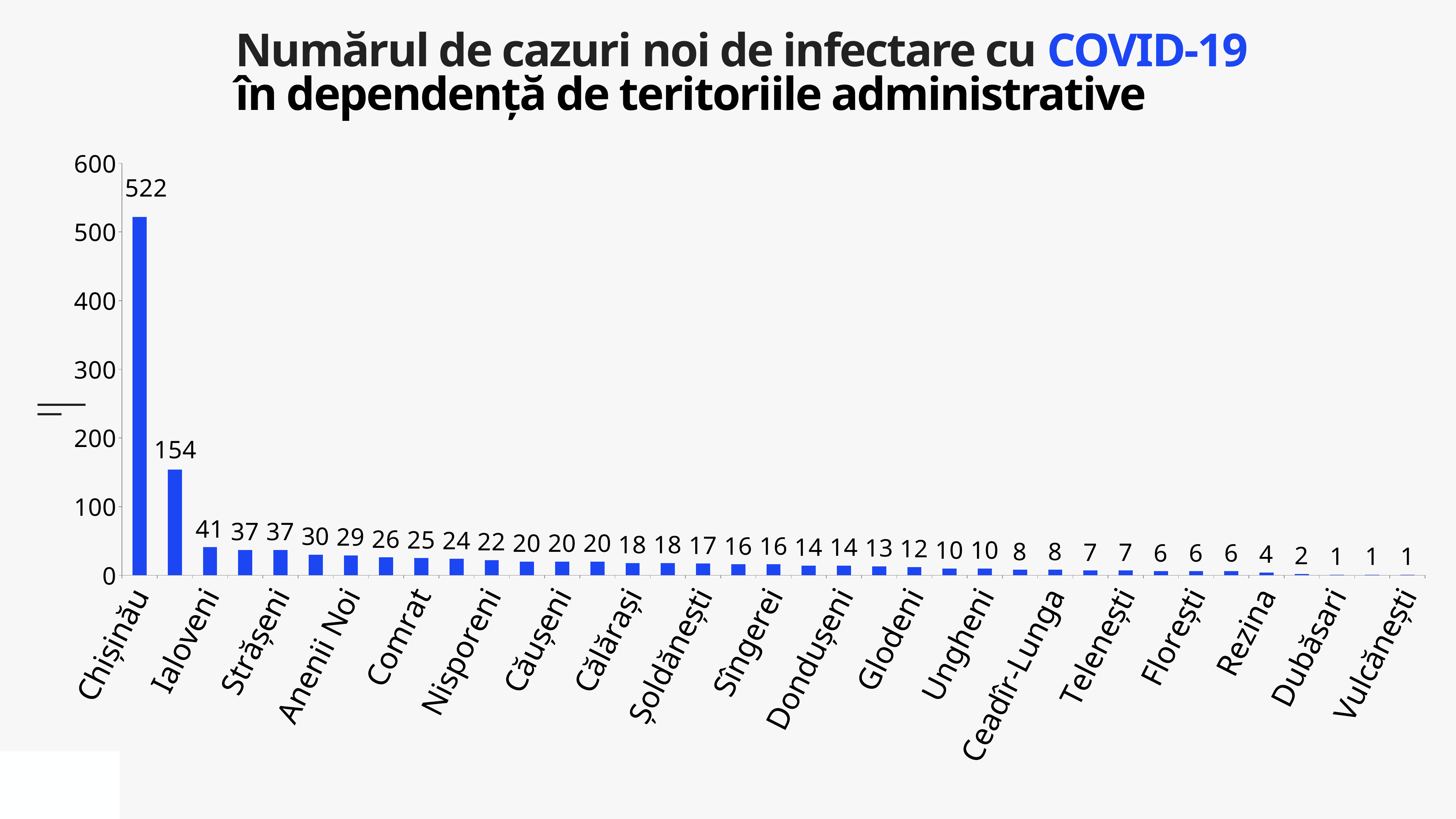
What type of chart is shown on the slide? bar chart What is the difference between the two tallest bars (522 and 154)? 368 Which is larger, the value for Chișinău or the value for Vulcănești? Chișinău What is the number of new COVID-19 cases for Vulcănești? 1 Which administrative territory has the highest number of new cases? Chișinău Is the value for Chișinău greater or less than 500? greater What is the number of new COVID-19 cases for Chișinău? 522 What is the highest value shown on the vertical axis? 600 How many bars are plotted in the chart? 37 What is the value of the second tallest bar in the chart? 154 Is the value for Vulcănești greater or less than 100? less Do the bar values rise or fall from left to right along the x axis? fall